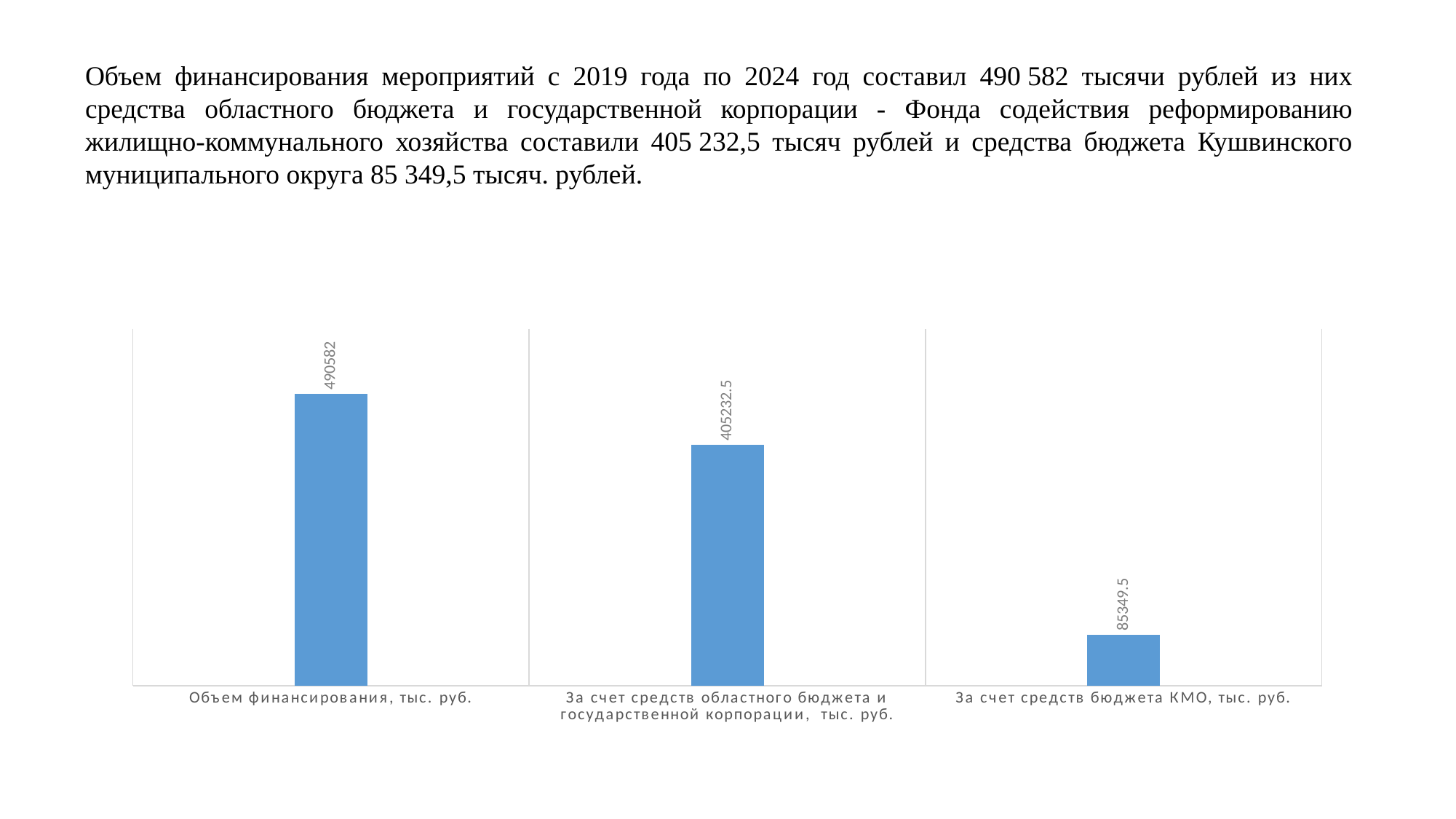
What colour are the bars in the chart? Blue What is the value of the bar labelled "Объем финансирования, тыс. руб."? 490582 How many bars are shown in the chart? 3 Which category has the lowest bar? За счет средств бюджета КМО, тыс. руб. What is the difference between the value for "За счет средств областного бюджета и государственной корпорации, тыс. руб." and the value for "За счет средств бюджета КМО, тыс. руб."? 319883 What is the value of the bar labelled "За счет средств областного бюджета и государственной корпорации, тыс. руб."? 405232.5 Which category has the highest bar? Объем финансирования, тыс. руб. What is the difference between the value for "Объем финансирования, тыс. руб." and the value for "За счет средств областного бюджета и государственной корпорации, тыс. руб."? 85349.5 What kind of chart is shown on the slide? Bar chart Do the bar values rise or fall from left to right across the chart? Fall What is the value of the bar labelled "За счет средств бюджета КМО, тыс. руб."? 85349.5 Which is larger: the value for "За счет средств областного бюджета и государственной корпорации, тыс. руб." or the value for "За счет средств бюджета КМО, тыс. руб."? За счет средств областного бюджета и государственной корпорации, тыс. руб.